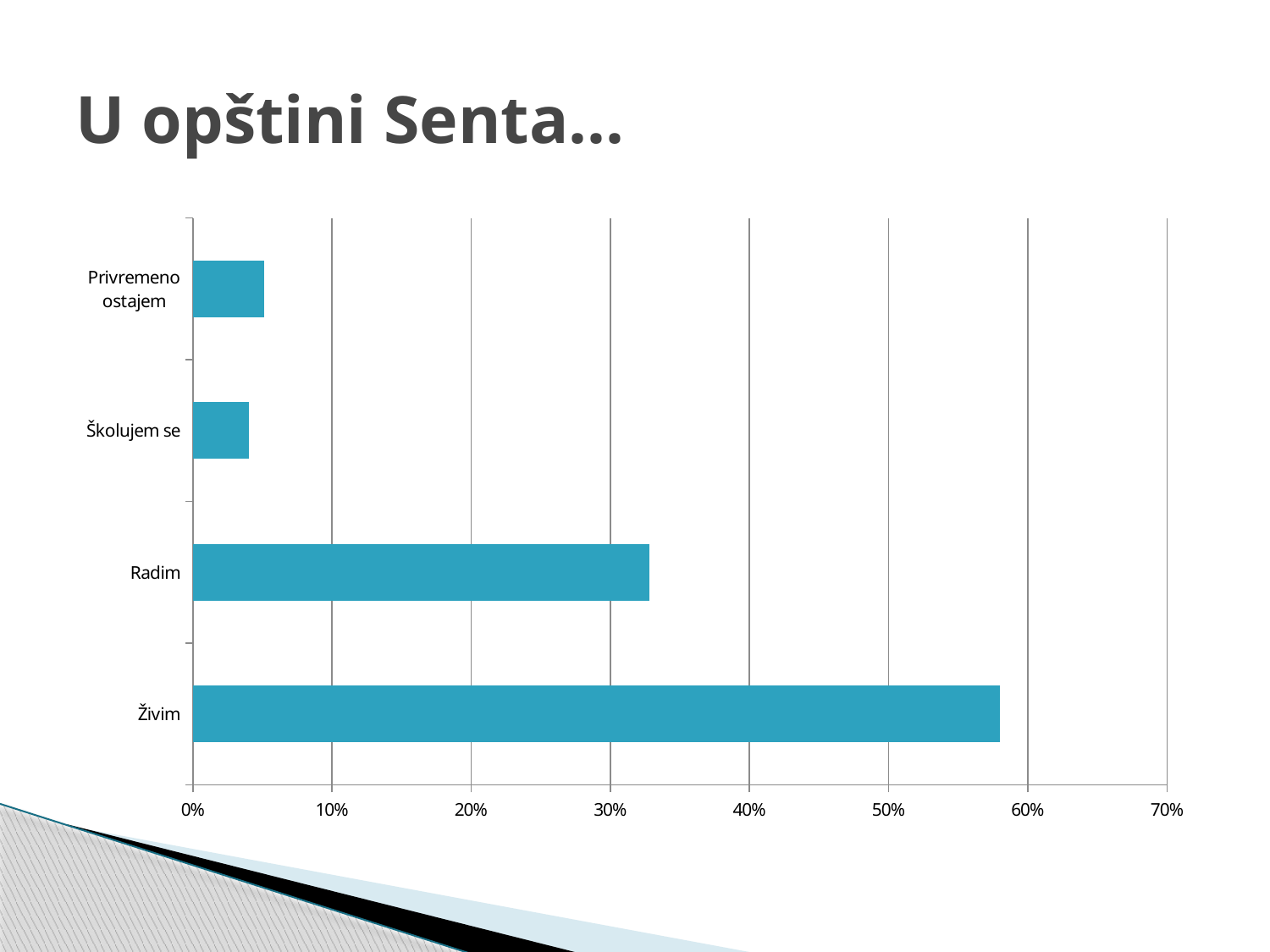
Which is larger, the value for Radim or the value for Živim? Živim What kind of chart is shown on the slide? bar chart Is the value for Privremeno ostajem greater or less than 10%? less Is the value for Živim greater or less than 60%? less Is the value for Školujem se greater or less than 10%? less How many categories are plotted in the chart? 4 Which is larger, the value for Radim or the value for Školujem se? Radim What is the title of the slide containing the chart? U opštini Senta… Which category has the highest value? Živim